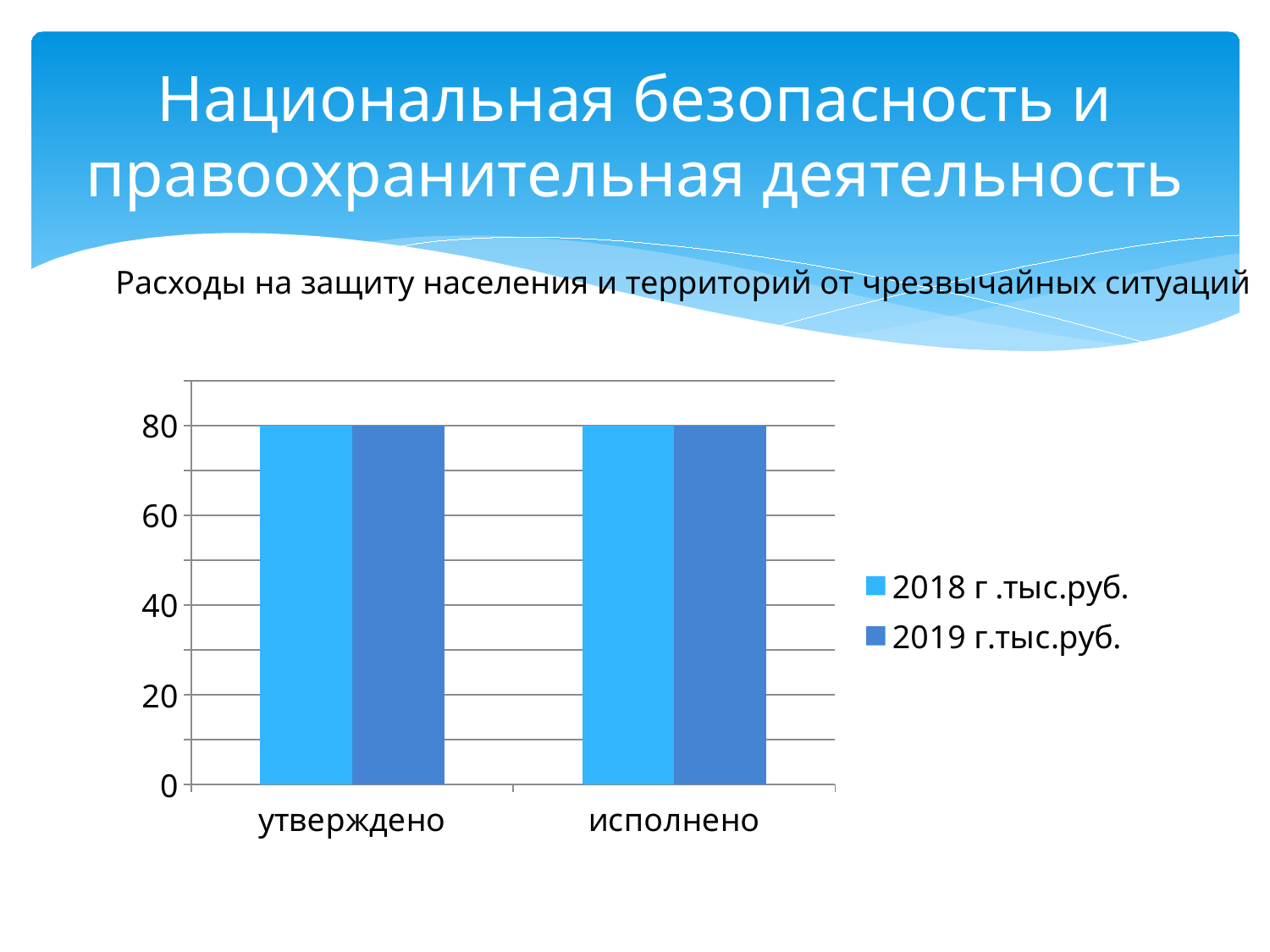
How many series does the chart legend list? 2 What is the value for 'исполнено' in the '2019 г.тыс.руб.' series? 80 Is the value for 'исполнено' in the '2019 г.тыс.руб.' series greater or less than 60? greater What is the value for 'исполнено' in the '2018 г .тыс.руб.' series? 80 What is the value for 'утверждено' in the '2018 г .тыс.руб.' series? 80 What is the difference between the '2018 г .тыс.руб.' values for 'утверждено' and 'исполнено'? 0 Which series is shown in the lighter blue colour? 2018 г .тыс.руб. What is the value for 'утверждено' in the '2019 г.тыс.руб.' series? 80 How many categories are shown on the x axis of the chart? 2 Do the '2018 г .тыс.руб.' values rise, fall or stay the same from 'утверждено' to 'исполнено'? stay the same What is the subtitle text above the chart? Расходы на защиту населения и территорий от чрезвычайных ситуаций What type of chart is shown on the slide? bar chart